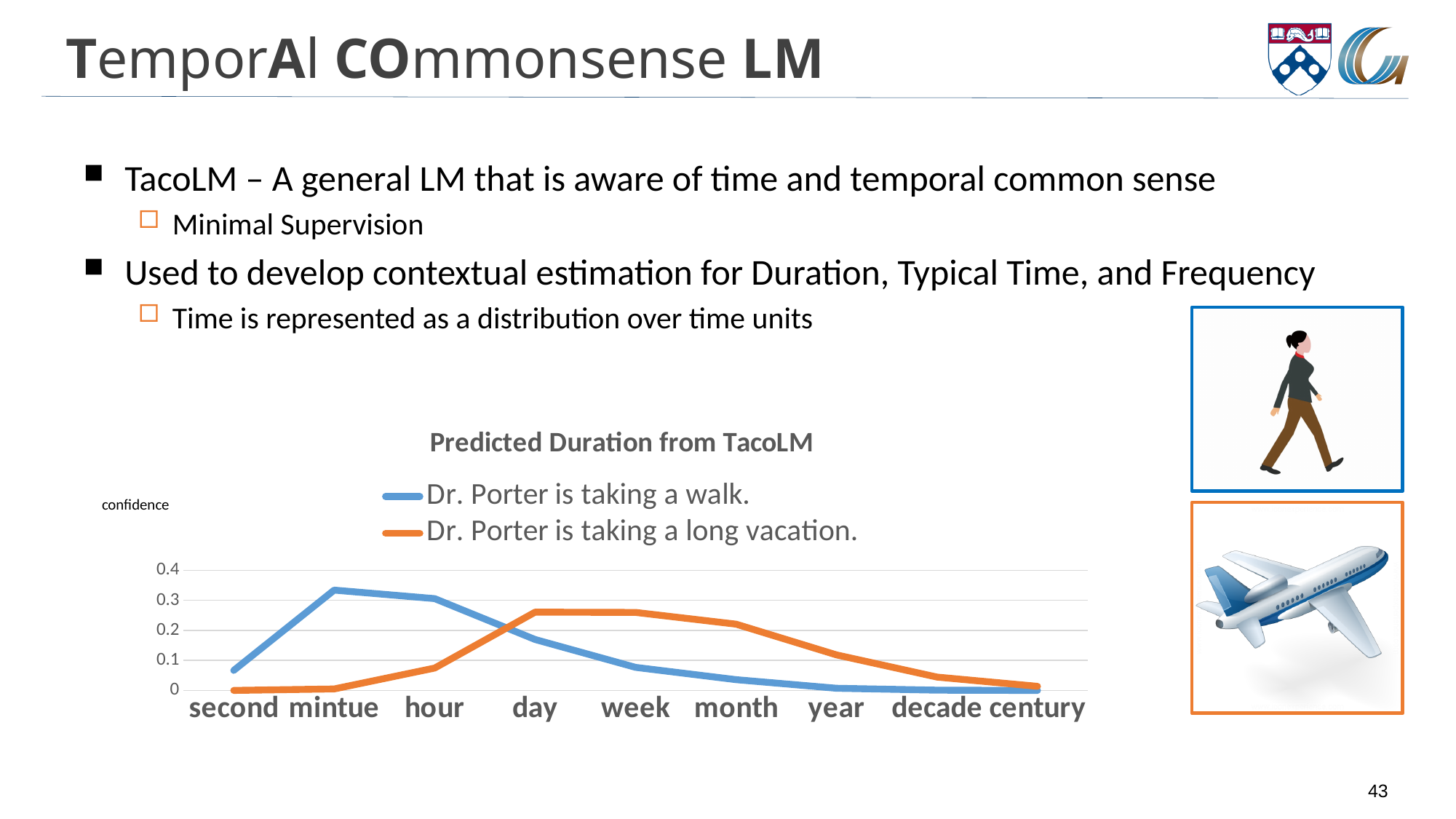
How many series does the legend list? 2 Does the 'Dr. Porter is taking a long vacation.' series rise or fall from week to century? fall Is the value for 'Dr. Porter is taking a long vacation.' at second greater or less than 0.1? less How many time-unit categories are on the x axis? 9 At month, which series has the larger value: 'Dr. Porter is taking a walk.' or 'Dr. Porter is taking a long vacation.'? Dr. Porter is taking a long vacation. For the series 'Dr. Porter is taking a walk.', which time unit has the highest confidence? mintue What kind of chart is shown on the slide? line chart What is the title of the chart? Predicted Duration from TacoLM Is the value for 'Dr. Porter is taking a walk.' at mintue greater or less than 0.3? greater At hour, which series has the larger value: 'Dr. Porter is taking a walk.' or 'Dr. Porter is taking a long vacation.'? Dr. Porter is taking a walk. Is the value for 'Dr. Porter is taking a long vacation.' at month greater or less than 0.2? greater